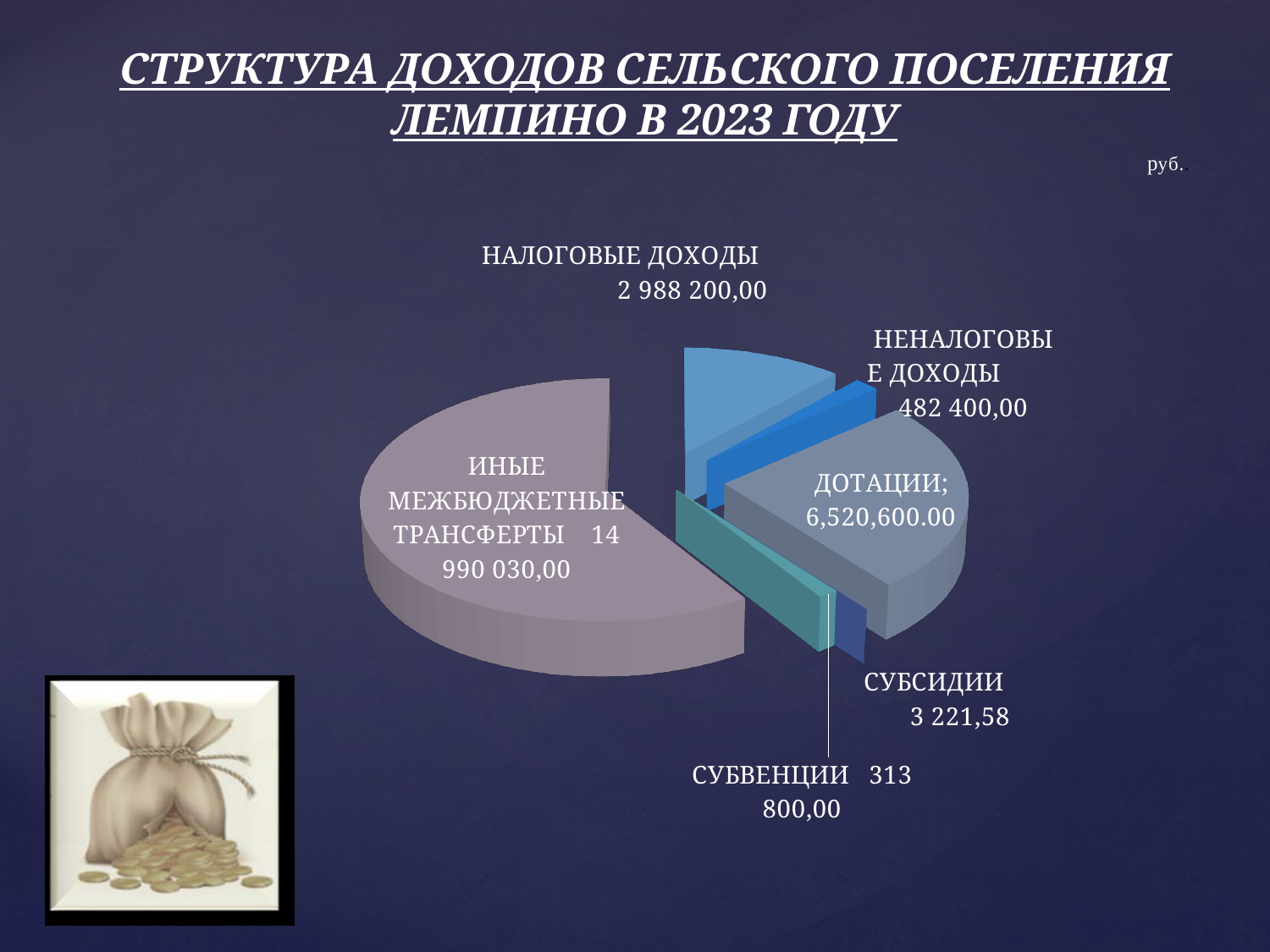
What value is shown for СУБСИДИИ? 3 221,58 What value is shown for НАЛОГОВЫЕ ДОХОДЫ? 2 988 200,00 What type of chart is shown on the slide? Pie chart What value is shown for ДОТАЦИИ? 6,520,600.00 What value is shown for НЕНАЛОГОВЫЕ ДОХОДЫ? 482 400,00 What value is shown for СУБВЕНЦИИ? 313 800,00 Which category has the smallest value? СУБСИДИИ How many categories are shown in the pie chart? 6 Which category has the largest value? ИНЫЕ МЕЖБЮДЖЕТНЫЕ ТРАНСФЕРТЫ What value is shown for ИНЫЕ МЕЖБЮДЖЕТНЫЕ ТРАНСФЕРТЫ? 14 990 030,00 What is the difference between НАЛОГОВЫЕ ДОХОДЫ and НЕНАЛОГОВЫЕ ДОХОДЫ? 2 505 800,00 Which is larger, НАЛОГОВЫЕ ДОХОДЫ or ДОТАЦИИ? ДОТАЦИИ